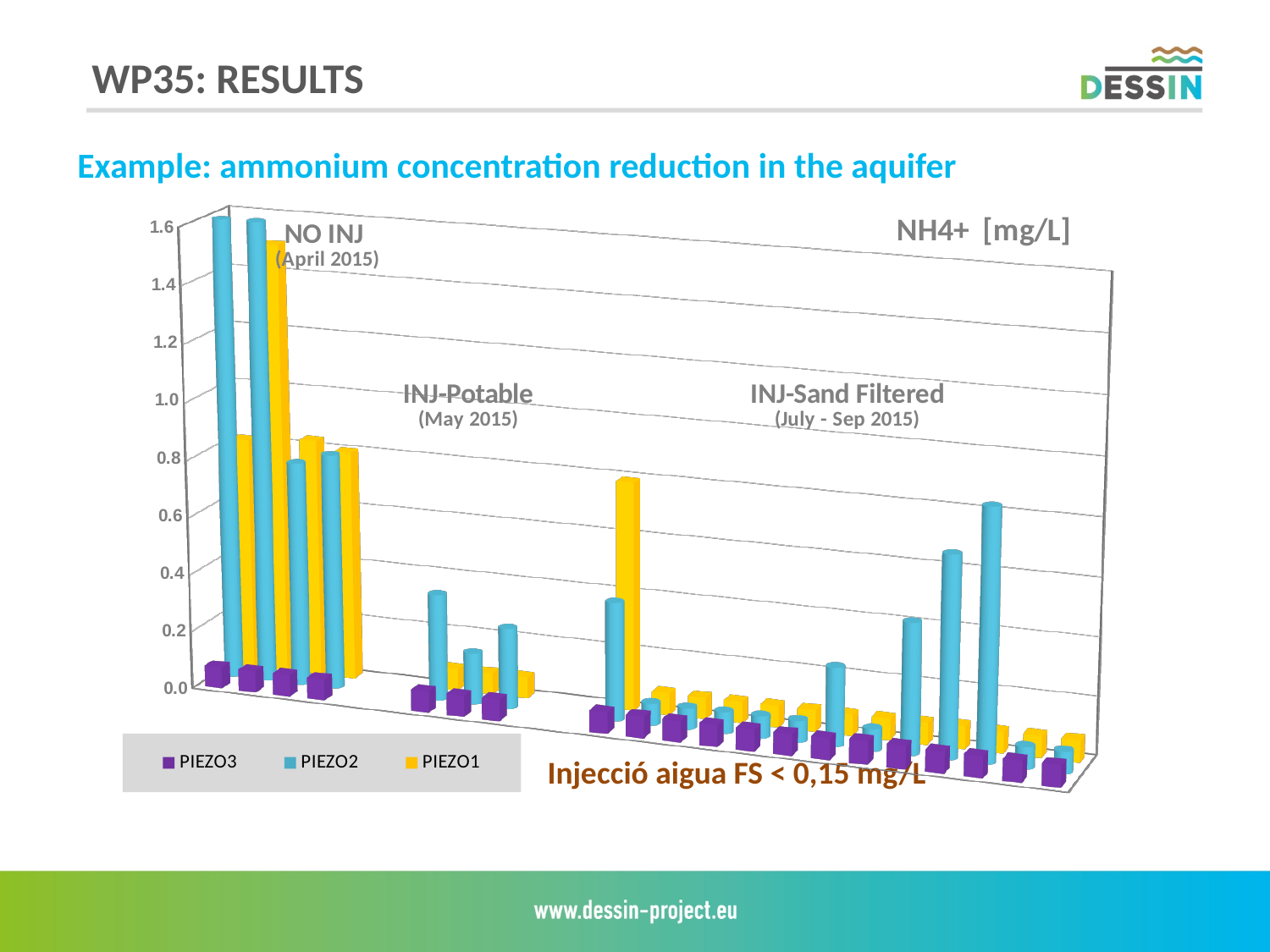
How many series does the chart legend list? 3 Is the tallest PIEZO2 bar in the NO INJ (April 2015) group greater or less than 1.4? greater Which series has the tallest bar in the chart? PIEZO2 Is the tallest PIEZO2 bar in the INJ-Potable (May 2015) group greater or less than 0.6? less How many injection periods (groups) are labelled on the chart? 3 What kind of chart is shown on the slide? bar chart Is the tallest PIEZO1 bar in the INJ-Potable (May 2015) group greater or less than 0.2? less What are the three series named in the chart legend? PIEZO3, PIEZO2, PIEZO1 In the NO INJ (April 2015) group, which series has larger values, PIEZO2 or PIEZO3? PIEZO2 Which series has the lowest values across the chart? PIEZO3 What is the highest value shown on the vertical axis? 1.6 What unit is given in the chart title for the NH4+ values? mg/L